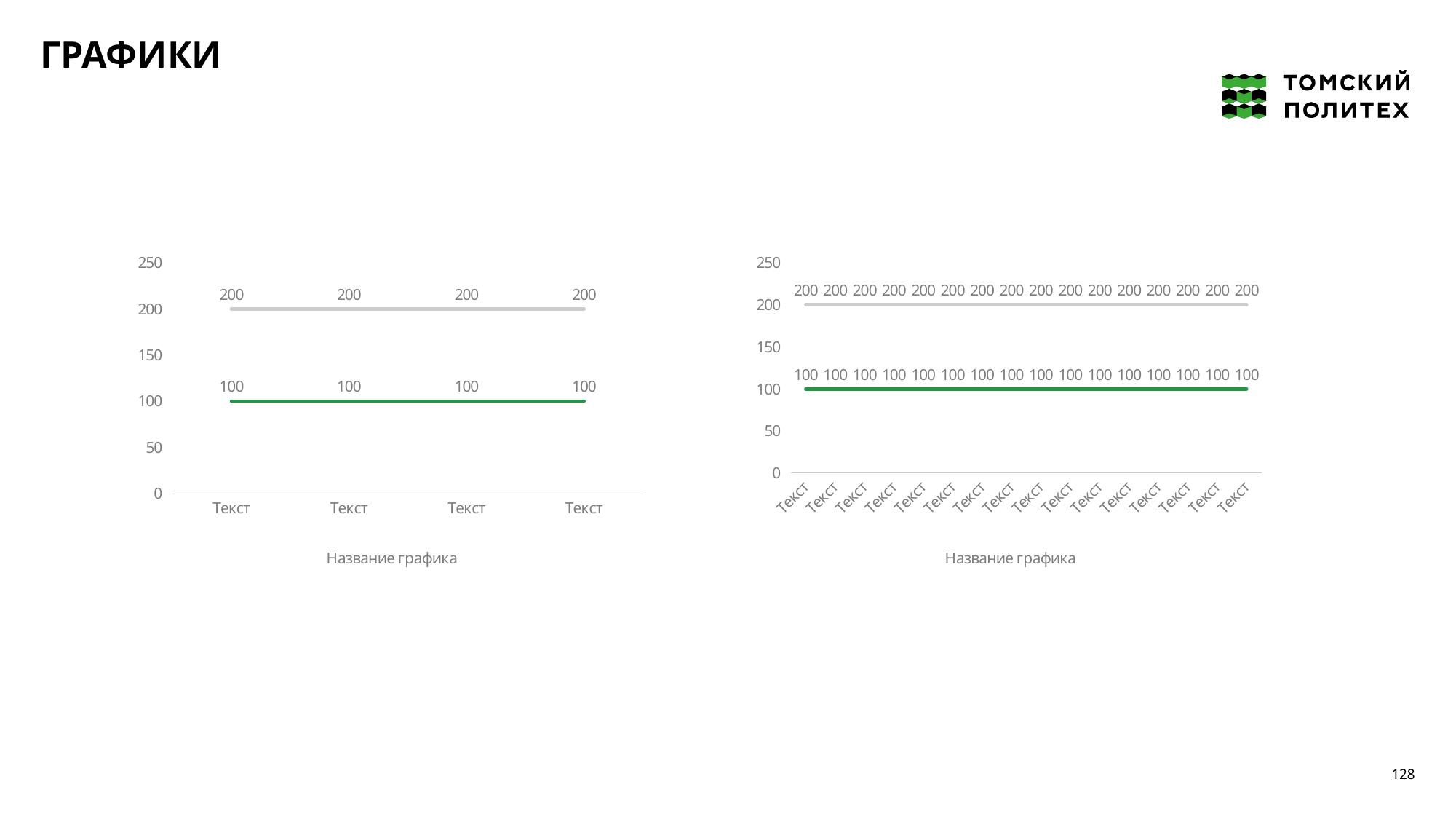
In the left chart, what value is labelled on the green line? 100 In the right chart, how many categories are shown on the x axis? 16 In the right chart, what value is labelled on the green line at the last category? 100 In the left chart, what is the difference between the grey line value and the green line value at the first category? 100 In the right chart, what value is labelled on the grey line at the first category? 200 In the right chart, do the values of the green line rise, fall, or stay flat along the x axis? stay flat In the left chart, what value is labelled on the grey line? 200 What kind of chart is the right chart on the slide? line chart In the left chart, how many categories are shown on the x axis? 4 What kind of chart is the left chart on the slide? line chart What is the title shown below the left chart? Название графика In the left chart, which line has the larger values, the grey line or the green line? the grey line